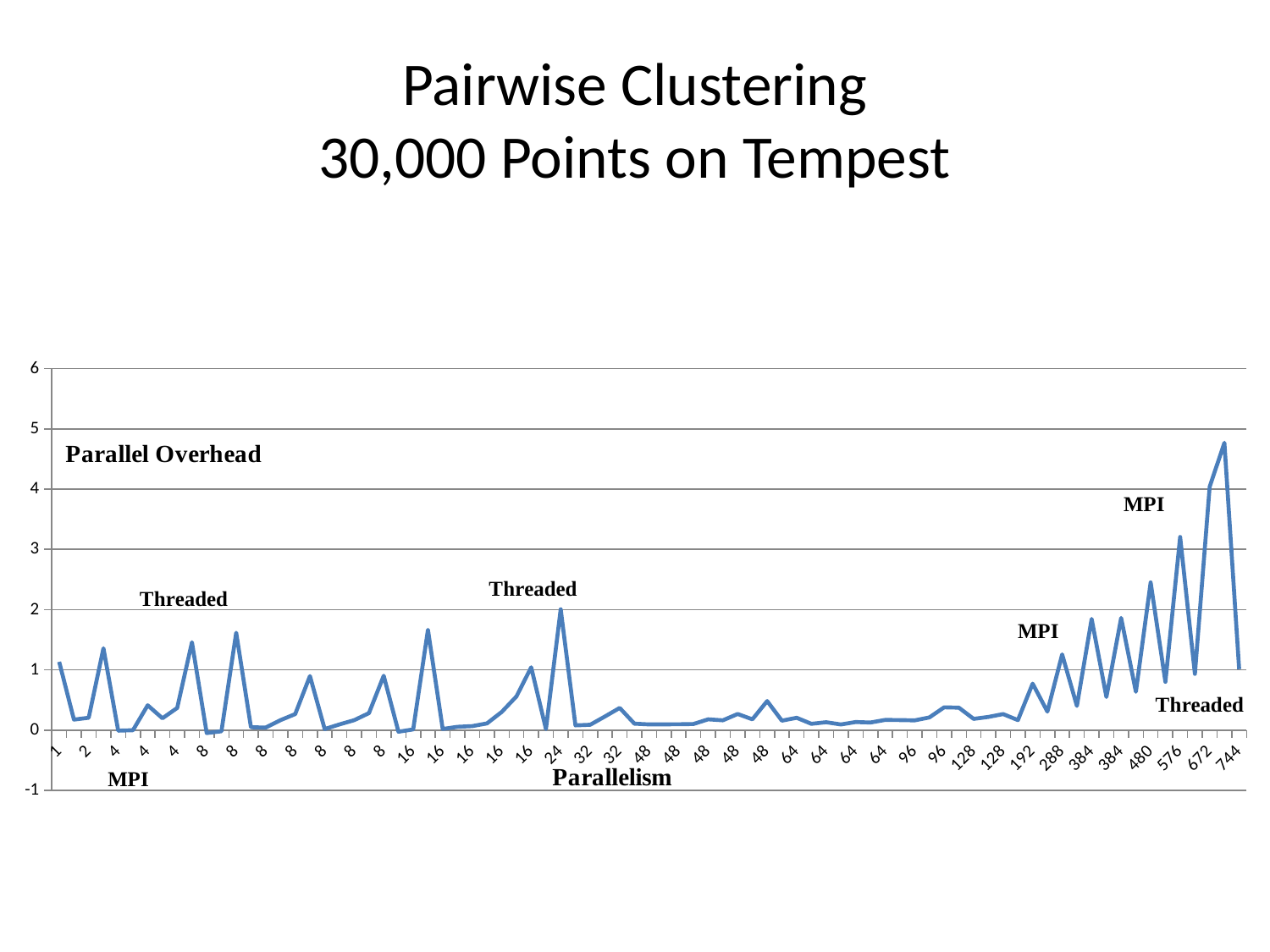
Are the values around parallelism 64 greater or less than 1? less Is the highest peak of the line greater or less than 5? less Is the highest peak of the line, at the right end of the chart, greater or less than 4? greater Which is larger: the highest MPI peak at the right end of the chart or the Threaded peak near parallelism 24? the MPI peak at the right end What is the label on the x axis of the chart? Parallelism What kind of chart is shown on the slide? line chart Do the peaks of the line generally rise or fall moving from parallelism 192 toward 672 on the x axis? rise What is the title of the slide's chart? Pairwise Clustering 30,000 Points on Tempest